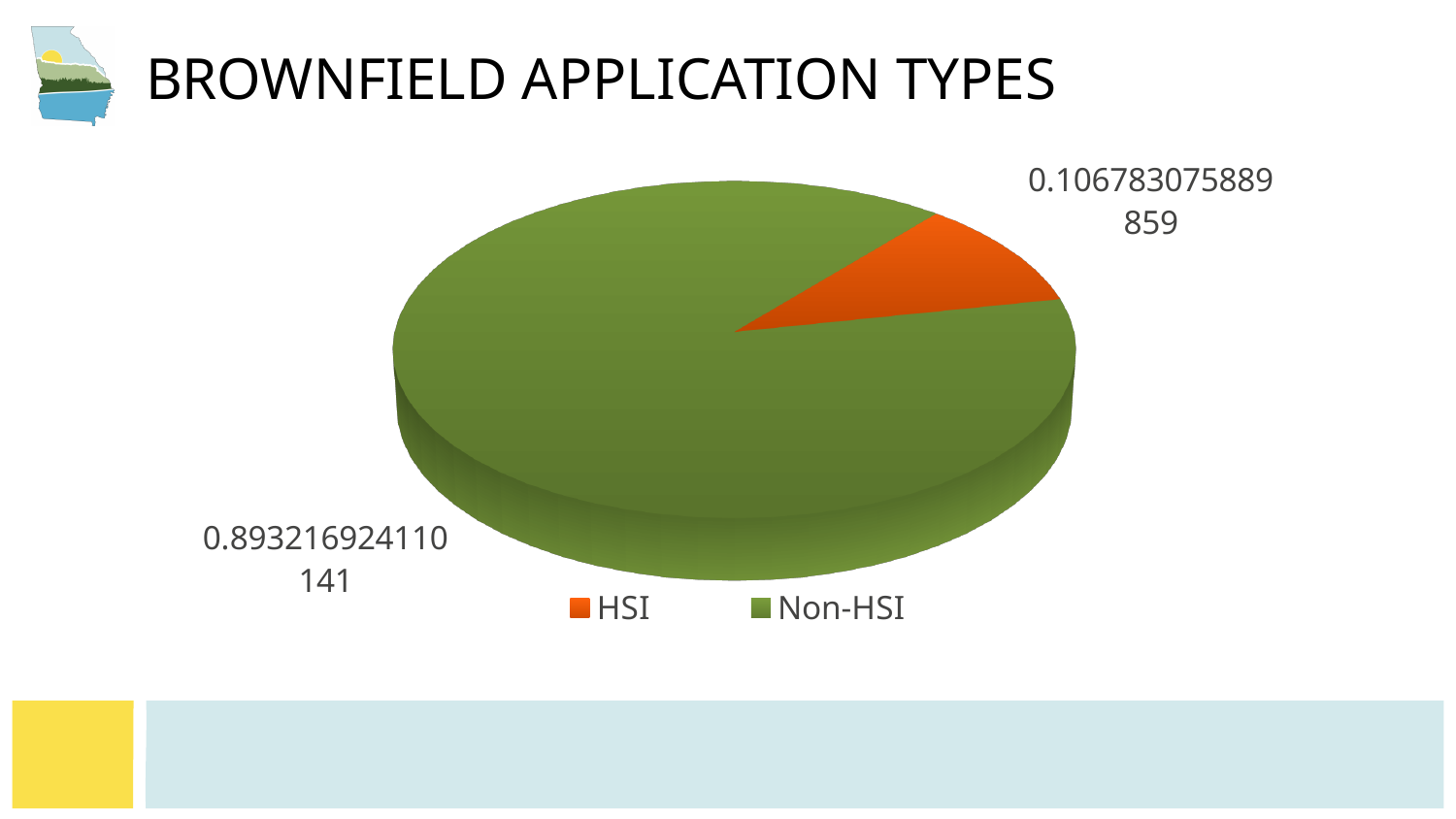
How many slices does the pie chart have? 2 Which category has the largest slice of the pie? Non-HSI Which category has the smallest slice of the pie? HSI What value is labelled on the HSI slice? 0.106783075889859 What value is labelled on the Non-HSI slice? 0.893216924110141 Which is larger, the HSI slice or the Non-HSI slice? Non-HSI What colour is the HSI slice in the pie chart? Orange How many entries does the legend list? 2 What is the title of the chart? BROWNFIELD APPLICATION TYPES Is the value for HSI greater or less than 0.5? less What kind of chart is shown on the slide? Pie chart Is the value for Non-HSI greater or less than 0.5? greater